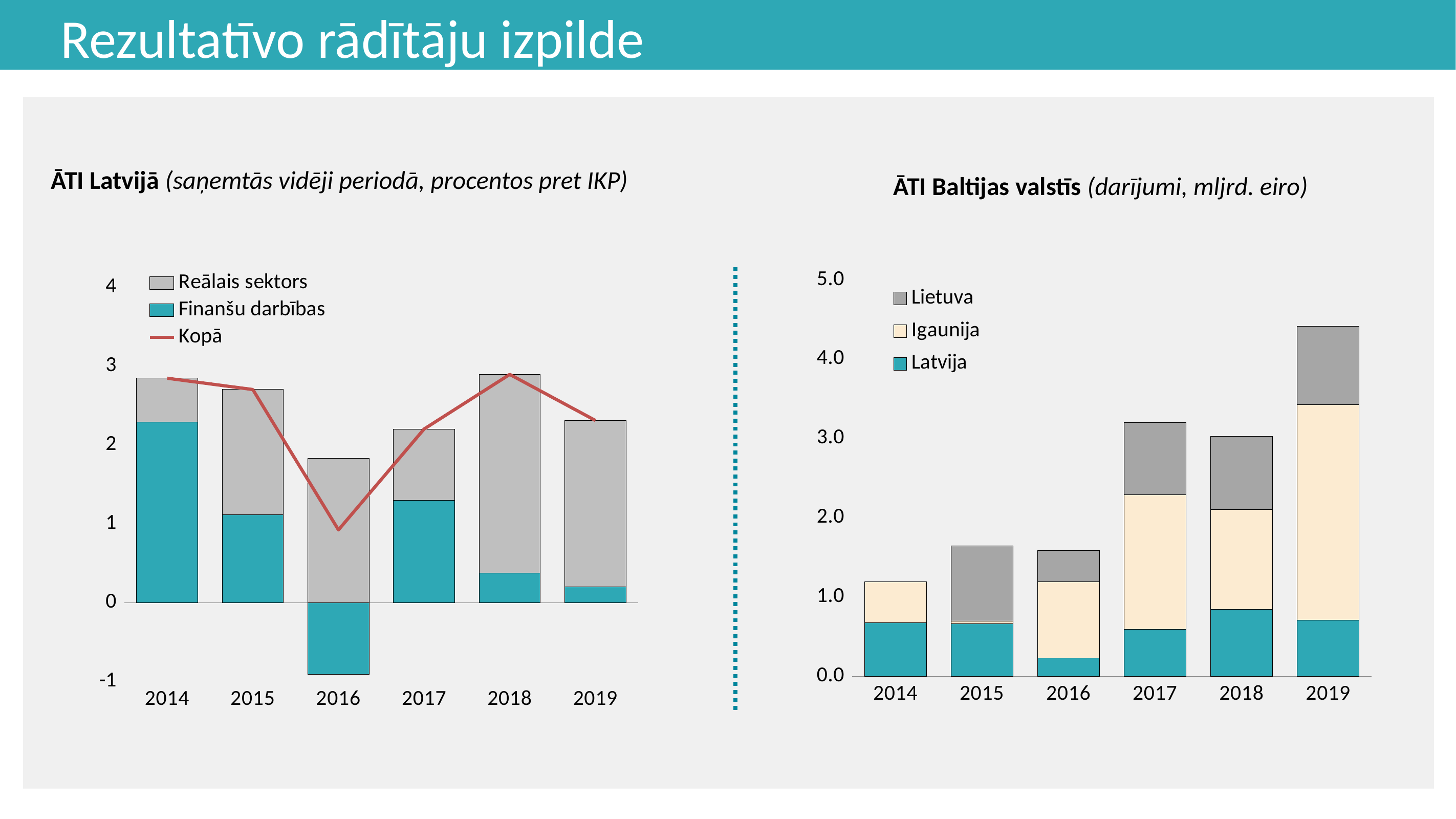
On the ĀTI Baltijas valstīs chart, which year has the lowest total bar? 2014 On the ĀTI Latvijā chart, how many series does the legend list? 3 On the ĀTI Baltijas valstīs chart, how many series does the legend list? 3 On the ĀTI Baltijas valstīs chart, what kind of chart is it? stacked bar chart On the ĀTI Latvijā chart, in which year is the Finanšu darbības value negative? 2016 On the ĀTI Latvijā chart, which series is drawn as a line rather than bars? Kopā On the ĀTI Latvijā chart, how many years are shown on the x axis? 6 On the ĀTI Latvijā chart, in which year is the Kopā line at its lowest? 2016 On the ĀTI Latvijā chart, is the Finanšu darbības value for 2014 greater or less than 2? greater On the ĀTI Baltijas valstīs chart, is the total for 2019 greater or less than 4.0? greater On the ĀTI Latvijā chart, is the Kopā value for 2016 greater or less than 2? less On the ĀTI Baltijas valstīs chart, which year has the highest total bar? 2019